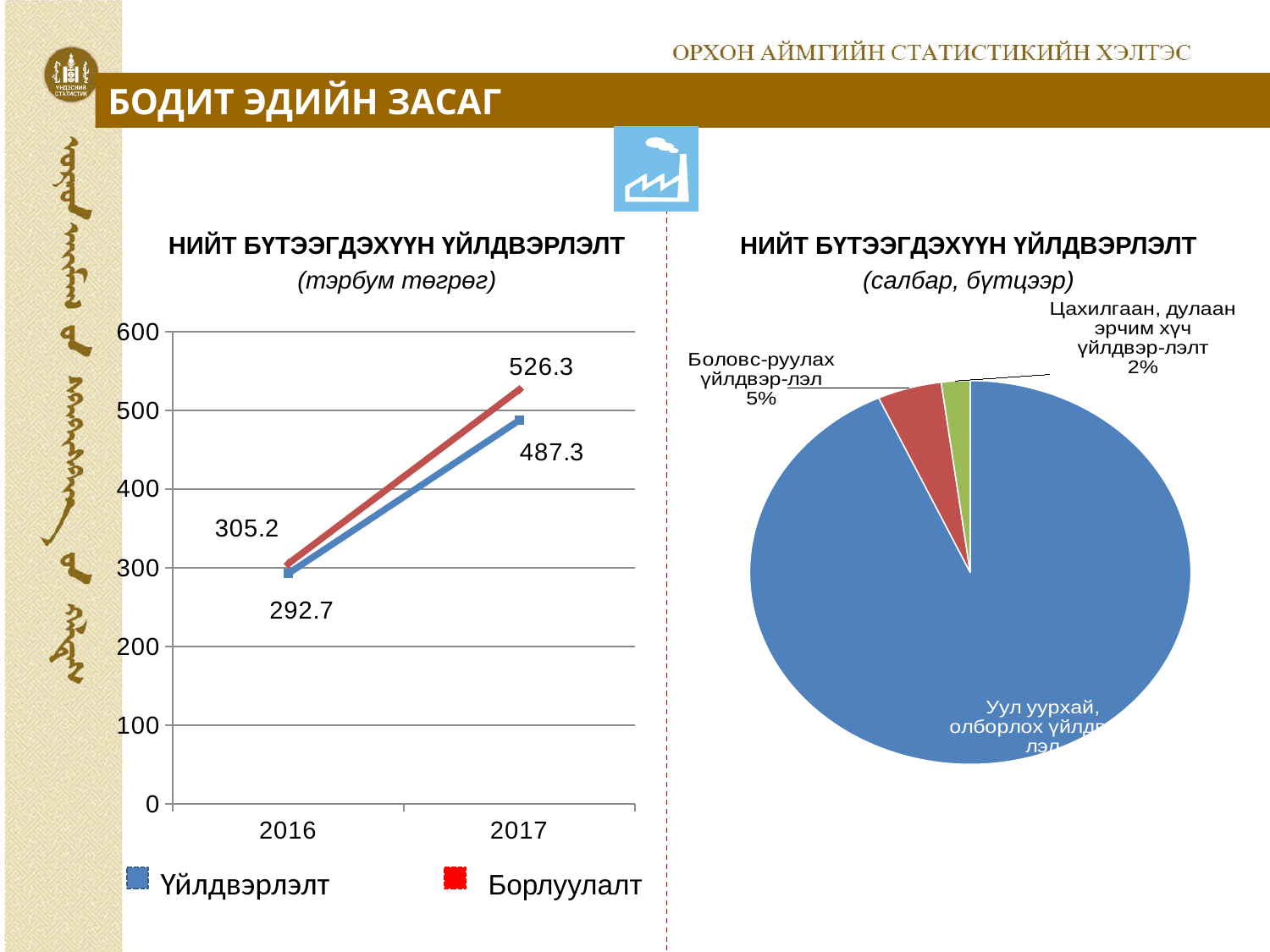
In the left line chart (тэрбум төгрөг), which series is higher in 2017, Үйлдвэрлэлт or Борлуулалт? Борлуулалт In the right pie chart (салбар, бүтцээр), what share does Боловсруулах үйлдвэрлэл have? 5% In the left line chart (тэрбум төгрөг), what is the value of Үйлдвэрлэлт in 2017? 487.3 How many series does the legend of the left line chart list? 2 In the right pie chart (салбар, бүтцээр), which sector has the largest slice? Уул уурхай, олборлох үйлдвэрлэл In the left line chart (тэрбум төгрөг), by how much did Үйлдвэрлэлт increase from 2016 to 2017? 194.6 In the left line chart (тэрбум төгрөг), what is the value of Борлуулалт in 2016? 305.2 In the left line chart (тэрбум төгрөг), what is the value of Борлуулалт in 2017? 526.3 What kind of chart is the chart on the right (салбар, бүтцээр)? pie chart In the left line chart (тэрбум төгрөг), what is the difference between Борлуулалт and Үйлдвэрлэлт in 2017? 39.0 In the left line chart (тэрбум төгрөг), do the values rise or fall from 2016 to 2017? rise In the left line chart (тэрбум төгрөг), what is the value of Үйлдвэрлэлт in 2016? 292.7